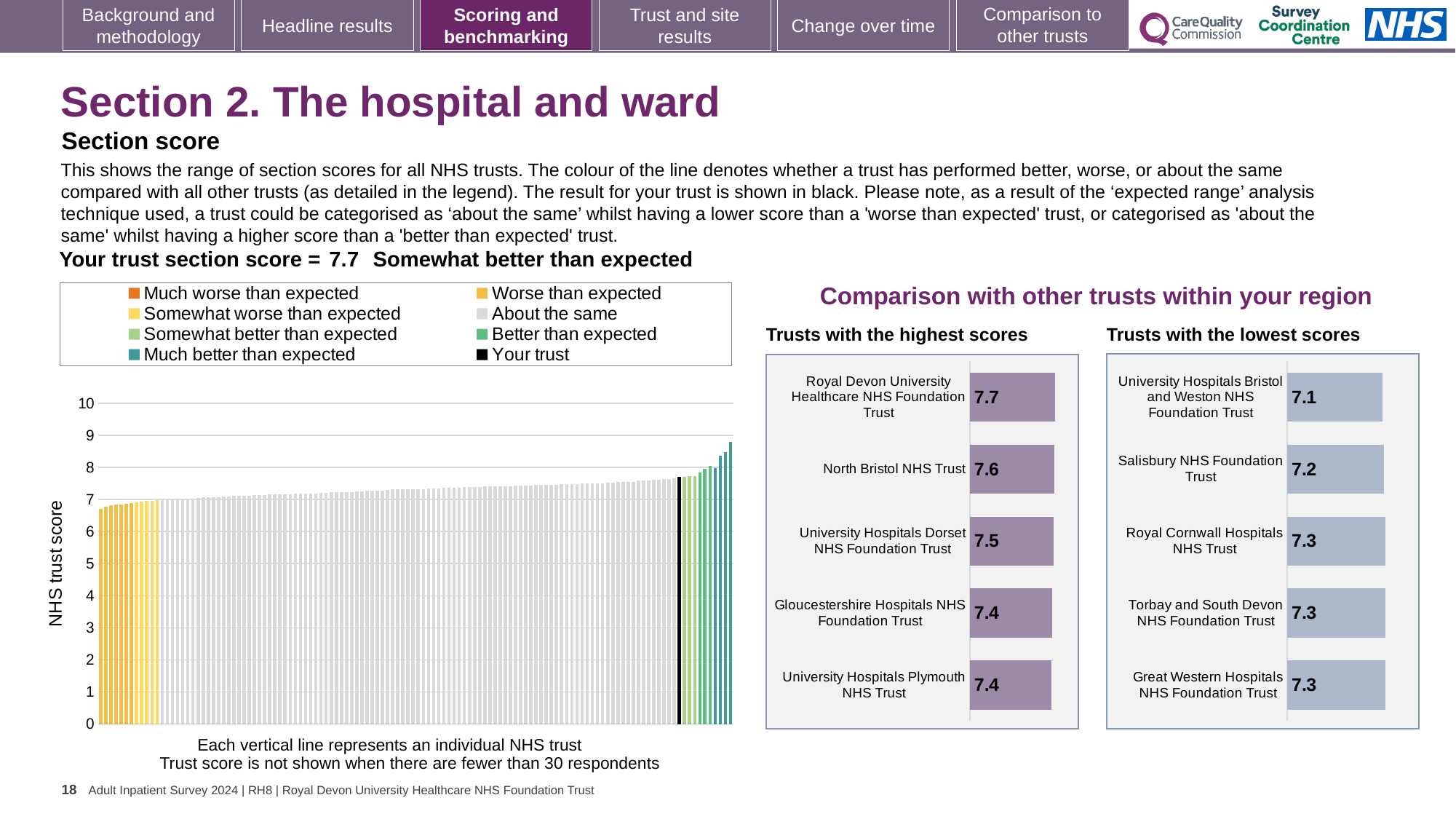
In the 'Trusts with the highest scores' chart, what is the score for North Bristol NHS Trust? 7.6 How many entries does the legend above the large chart on the left list? 8 In the large chart on the left, do the bar values rise or fall from left to right? Rise In the 'Trusts with the highest scores' chart, how many trusts are listed? 5 What kind of chart is the large chart on the left showing NHS trust scores? Bar chart In the large chart on the left, is the value of the black bar (your trust) greater or less than 7? greater In the 'Trusts with the lowest scores' chart, which has the larger score: University Hospitals Bristol and Weston NHS Foundation Trust or Royal Cornwall Hospitals NHS Trust? Royal Cornwall Hospitals NHS Trust In the 'Trusts with the lowest scores' chart, what is the score for Salisbury NHS Foundation Trust? 7.2 In the 'Trusts with the highest scores' chart, which trust has the highest score? Royal Devon University Healthcare NHS Foundation Trust In the 'Trusts with the lowest scores' chart, what is the score for Great Western Hospitals NHS Foundation Trust? 7.3 In the 'Trusts with the lowest scores' chart, which trust has the lowest score? University Hospitals Bristol and Weston NHS Foundation Trust In the 'Trusts with the highest scores' chart, what is the difference between the scores of Royal Devon University Healthcare NHS Foundation Trust and University Hospitals Dorset NHS Foundation Trust? 0.2